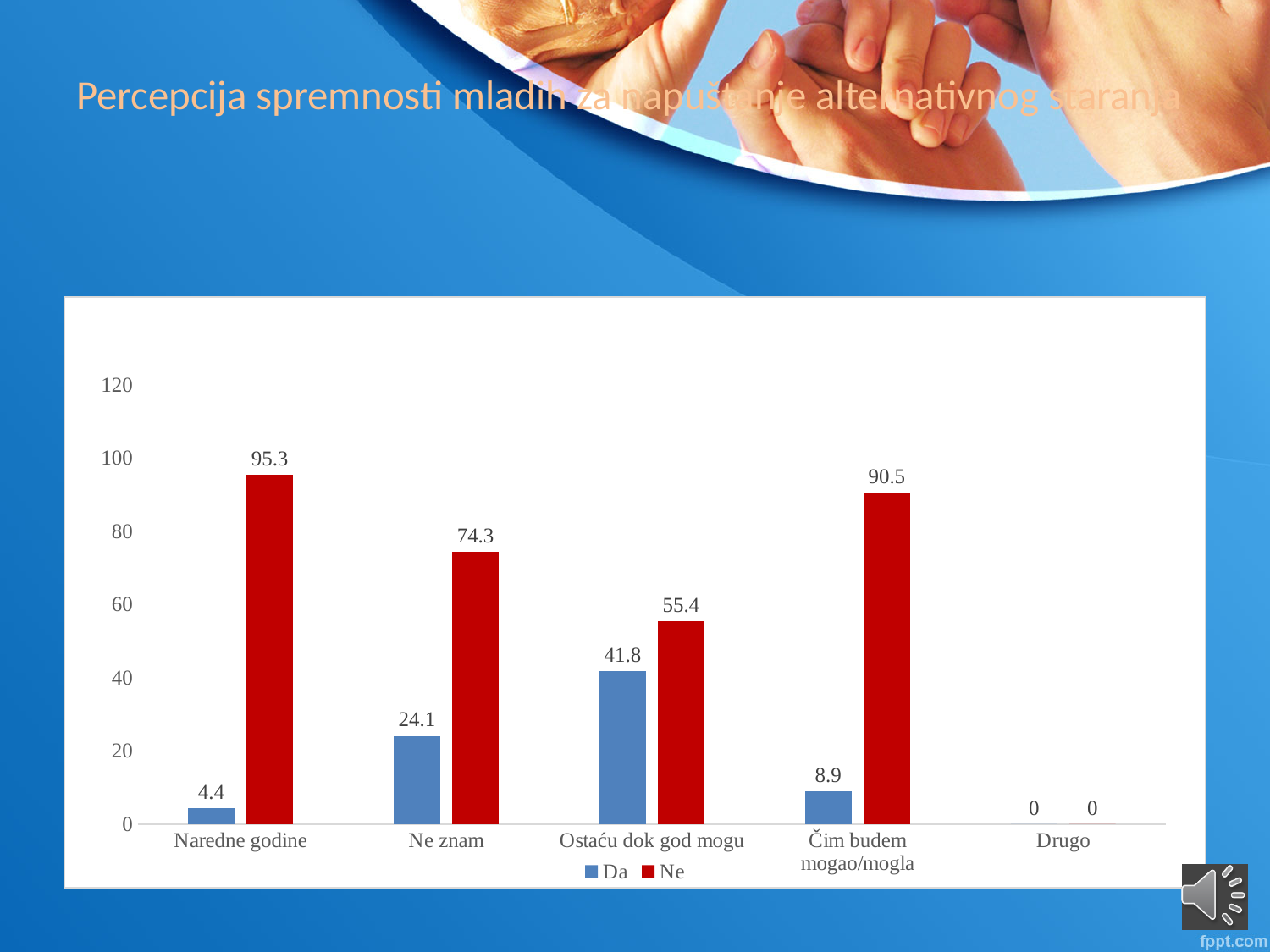
What is the value for "Da" in the "Čim budem mogao/mogla" category? 8.9 Which is larger in the "Ostaću dok god mogu" category, the "Da" value or the "Ne" value? Ne How many series does the legend list? 2 What colour are the bars for the "Ne" series? red Is the "Ne" value for "Čim budem mogao/mogla" greater or less than 80? greater What is the value for "Ne" in the "Naredne godine" category? 95.3 What is the difference between the "Ne" and "Da" values in the "Ne znam" category? 50.2 What kind of chart is shown on the slide? bar chart Which category has the lowest value for the "Ne" series? Drugo What is the value for "Da" in the "Ostaću dok god mogu" category? 41.8 How many categories are shown on the x axis? 5 Which category has the highest value for the "Da" series? Ostaću dok god mogu